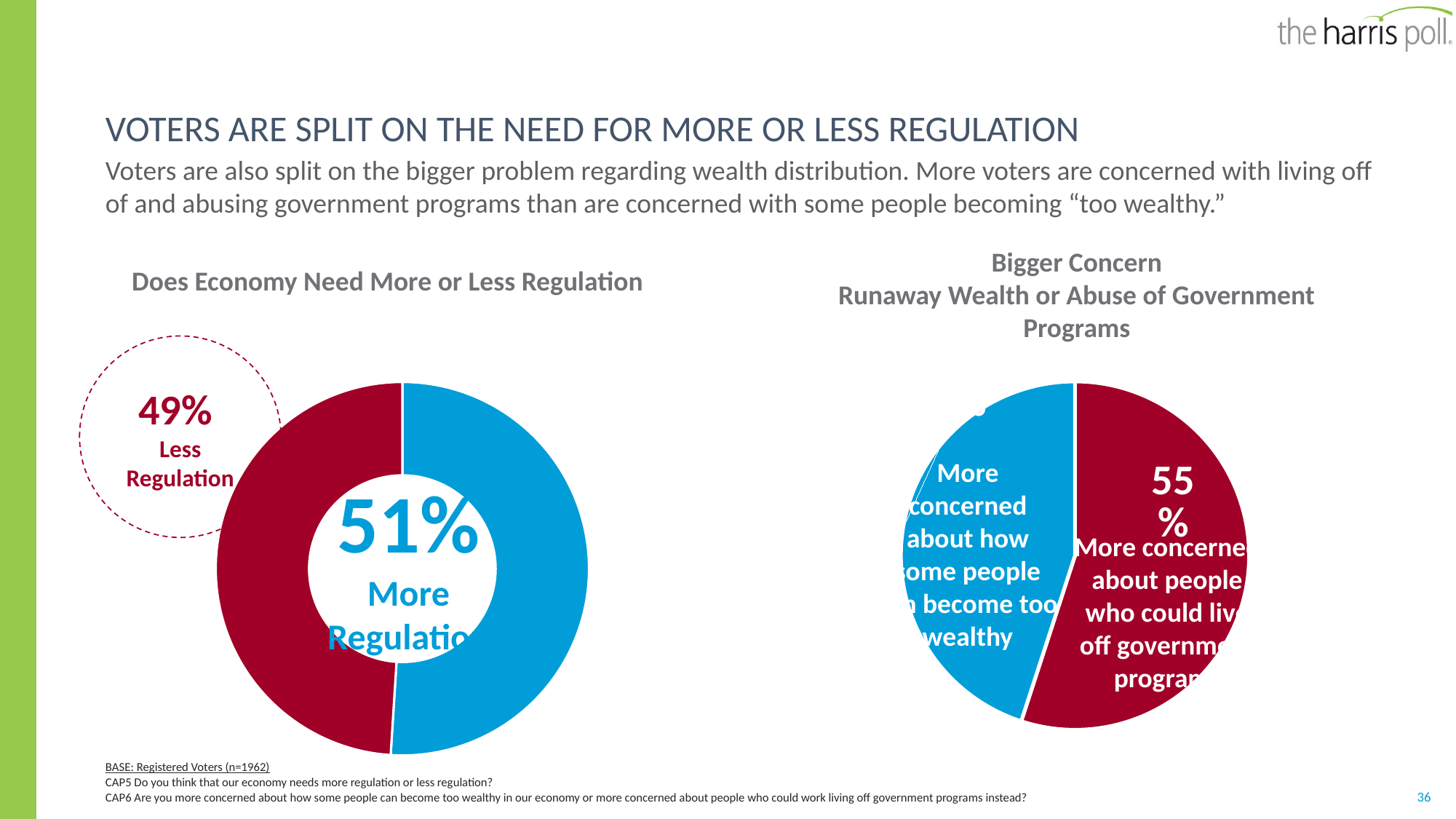
In the chart titled "Bigger Concern Runaway Wealth or Abuse of Government Programs", what percentage of voters are more concerned about people who could live off government programs? 55% In the chart titled "Bigger Concern Runaway Wealth or Abuse of Government Programs", what colour is the slice for people more concerned about how some people can become too wealthy? Blue In the chart titled "Does Economy Need More or Less Regulation", what percentage of voters say the economy needs less regulation? 49% In the chart titled "Does Economy Need More or Less Regulation", what is the difference in percentage points between More Regulation and Less Regulation? 2 percentage points In the chart titled "Does Economy Need More or Less Regulation", what colour is the Less Regulation segment? Red What kind of chart is the one titled "Does Economy Need More or Less Regulation"? Donut (pie) chart In the chart titled "Does Economy Need More or Less Regulation", which response has the larger share, More Regulation or Less Regulation? More Regulation In the chart titled "Does Economy Need More or Less Regulation", how many categories are shown? 2 In the chart titled "Bigger Concern Runaway Wealth or Abuse of Government Programs", how many slices are shown? 2 In the chart titled "Bigger Concern Runaway Wealth or Abuse of Government Programs", which concern has the larger share? More concerned about people who could live off government programs In the chart titled "Does Economy Need More or Less Regulation", what percentage of voters say the economy needs more regulation? 51% What kind of chart is the one titled "Bigger Concern Runaway Wealth or Abuse of Government Programs"? Pie chart